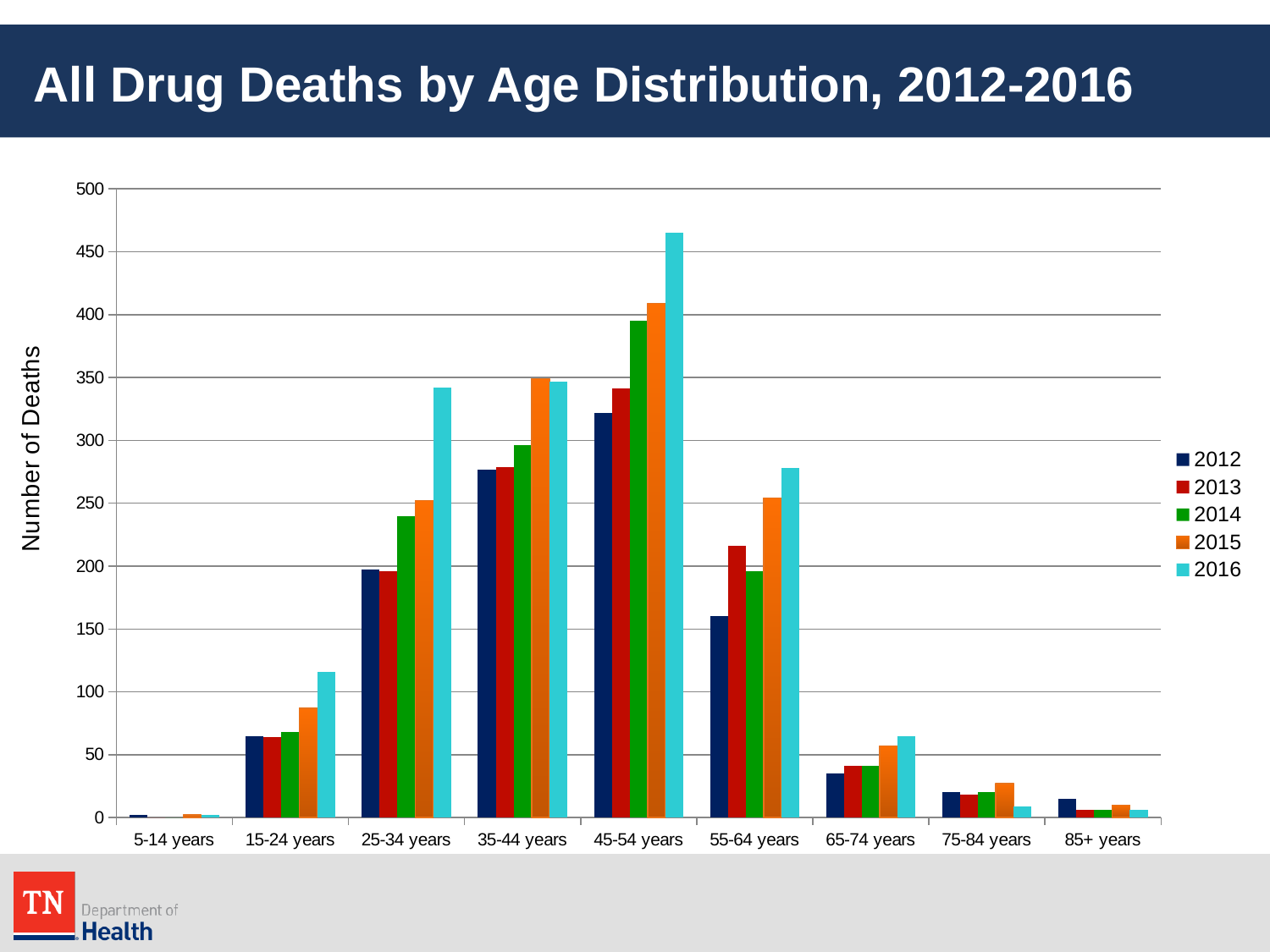
For 25-34 years, which is larger: the 2012 value or the 2016 value? 2016 How many series does the legend list? 5 Is the 2016 value for 45-54 years greater or less than 450? greater What kind of chart is shown on the slide? bar chart What is the label on the vertical axis? Number of Deaths Which age group has the lowest number of deaths for 2015? 5-14 years For the 45-54 years group, do the values rise or fall from 2012 to 2016? rise How many age groups are shown on the x axis? 9 Which age group has the highest number of deaths for 2016? 45-54 years For 55-64 years, which is larger: the 2013 value or the 2014 value? 2013 Is the 2012 value for 55-64 years greater or less than 200? less Is the 2016 value for 15-24 years greater or less than 100? greater